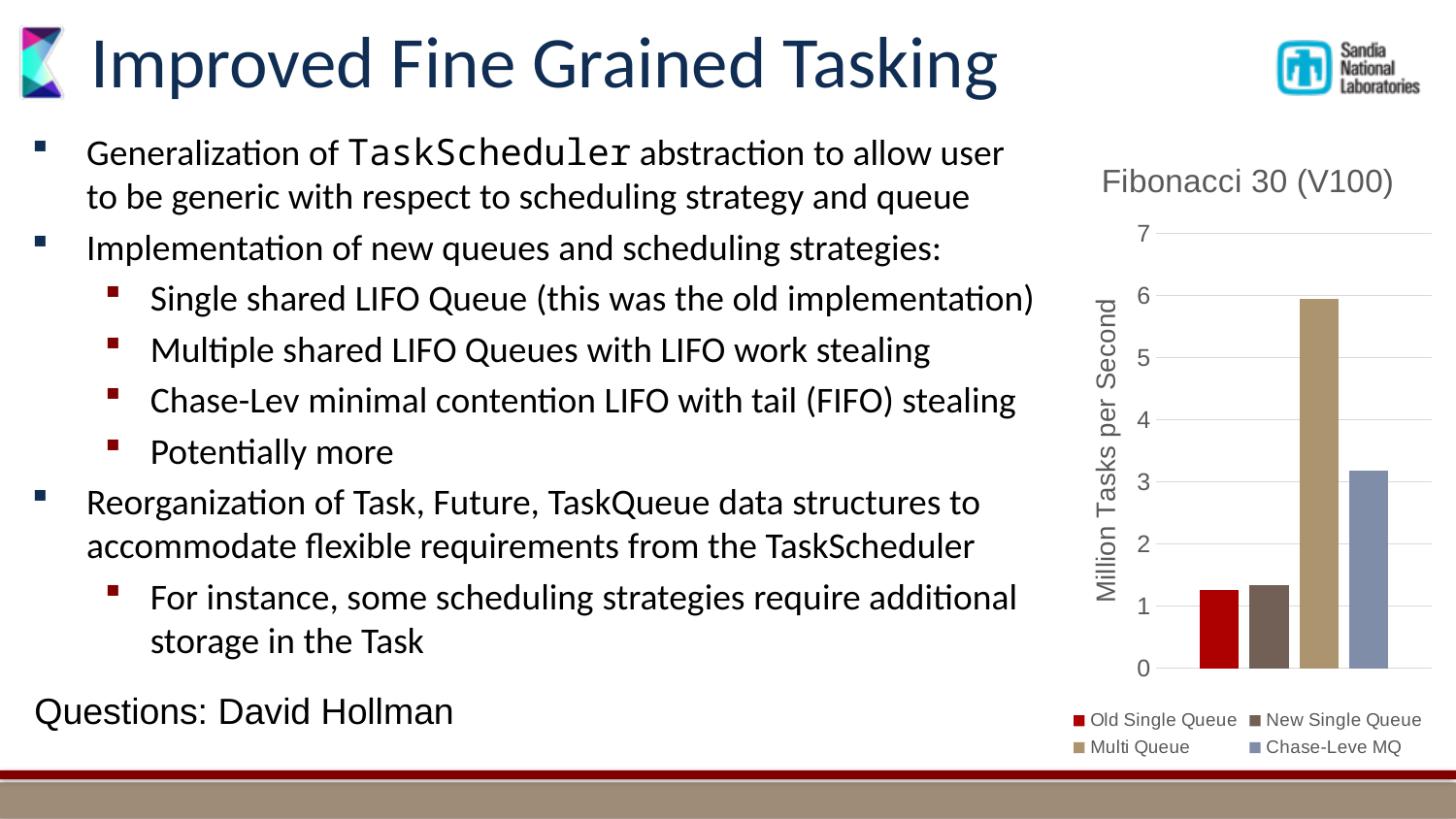
How many bars are plotted in the chart? 4 Is the value for Multi Queue greater or less than 5? greater Is the value for New Single Queue greater or less than 1? greater Which is larger, the value for Multi Queue or the value for Chase-Leve MQ? Multi Queue What is the label of the vertical axis of the chart? Million Tasks per Second How many series does the chart legend list? 4 What kind of chart is shown on the slide? bar chart Which is larger, the value for Chase-Leve MQ or the value for Old Single Queue? Chase-Leve MQ What is the title of the chart? Fibonacci 30 (V100) Is the value for Chase-Leve MQ greater or less than 4? less Which series has the highest value in the chart? Multi Queue